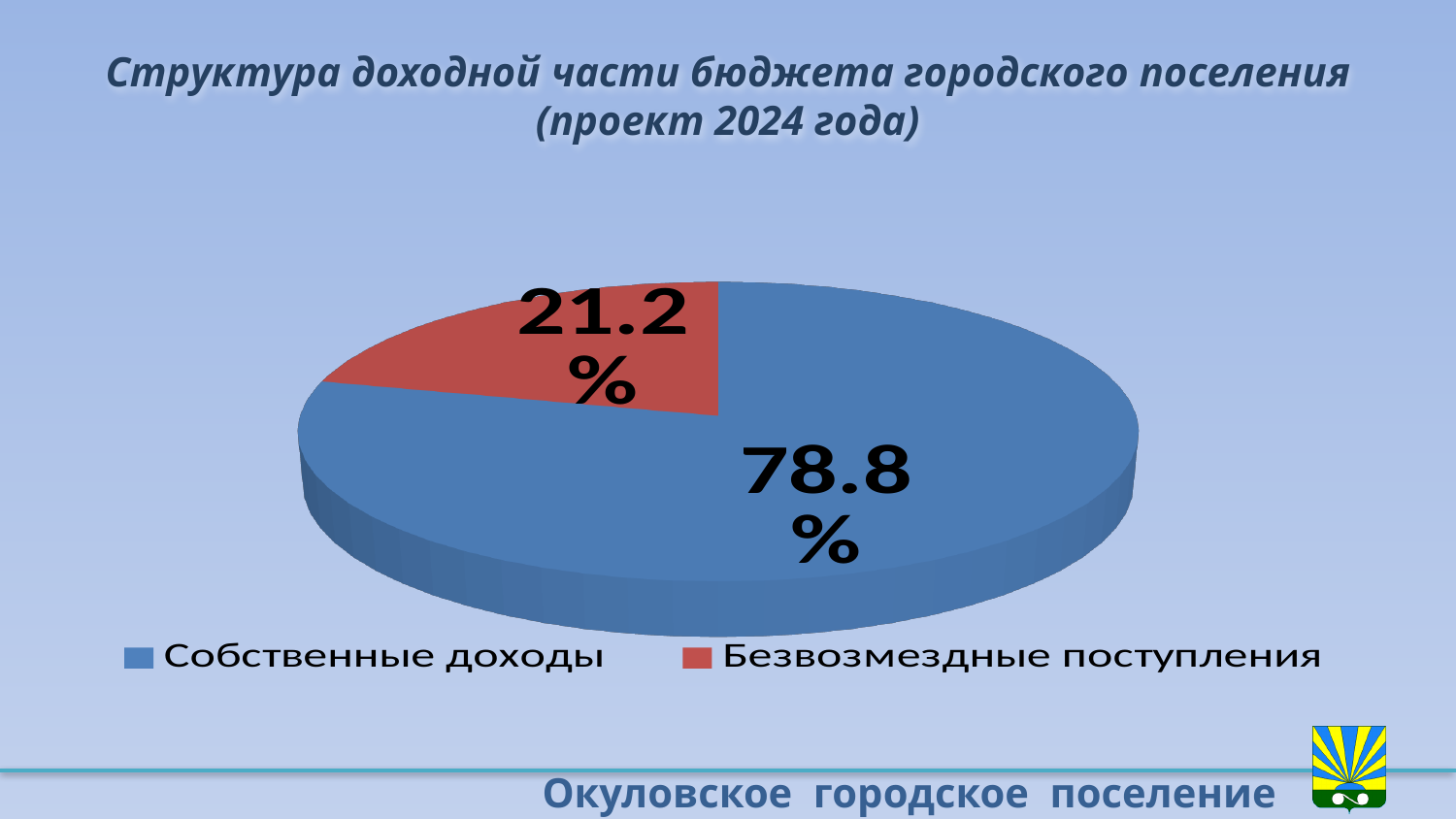
What is the title of the chart on the slide? Структура доходной части бюджета городского поселения (проект 2024 года) How many entries does the legend list? 2 Which category has the smallest slice of the pie? Безвозмездные поступления What kind of chart is shown on the slide? Pie chart What is the difference in percentage points between Собственные доходы and Безвозмездные поступления? 57.6 What colour is the slice for Безвозмездные поступления? Red What share of the pie does Безвозмездные поступления have? 21.2% Which is larger, Собственные доходы or Безвозмездные поступления? Собственные доходы What share of the pie does Собственные доходы have? 78.8% Which category has the largest slice of the pie? Собственные доходы How many slices does the pie chart have? 2